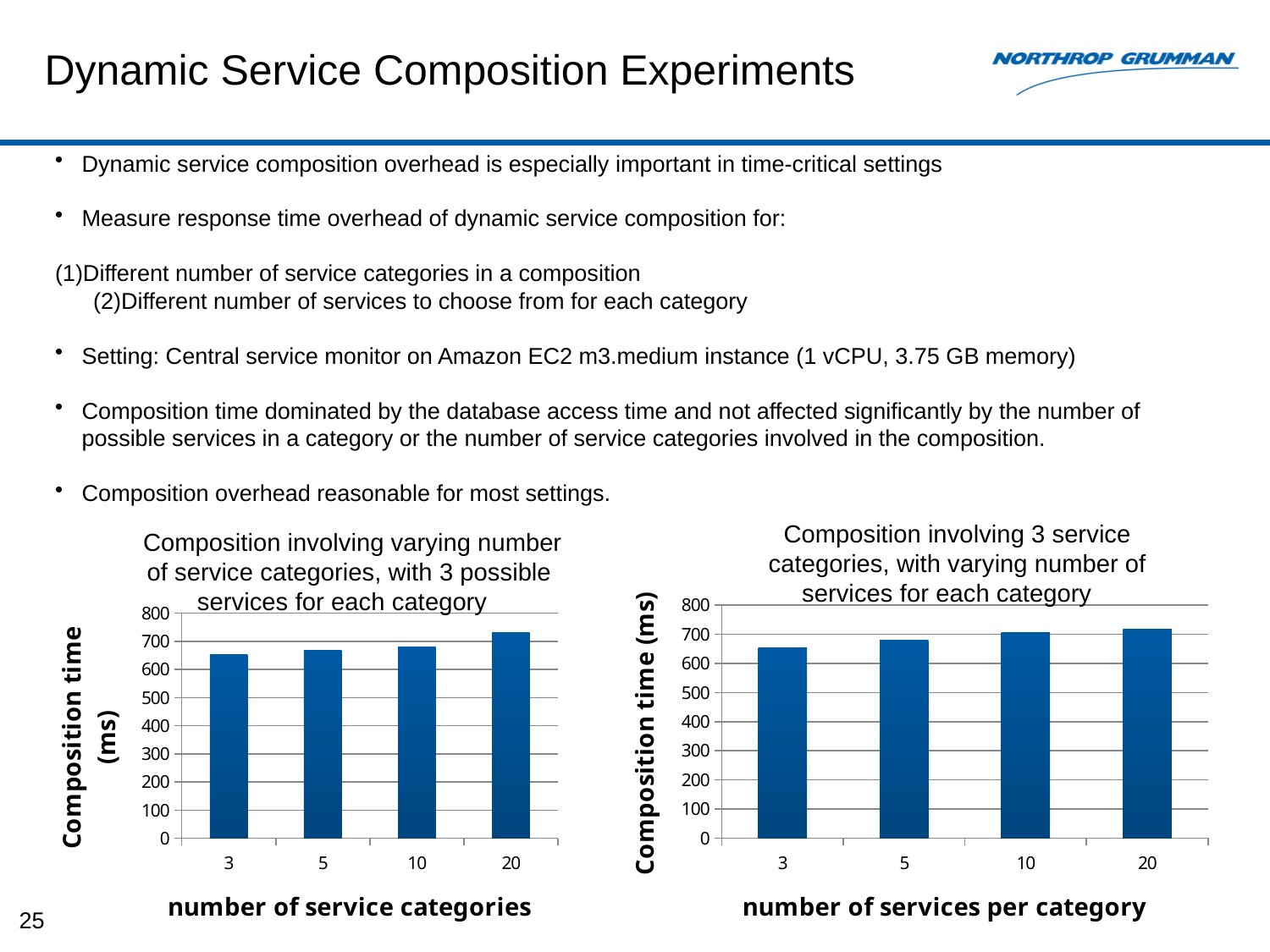
In the left chart (varying number of service categories), do the composition times rise or fall as the number of service categories increases from 3 to 20? rise In the left chart (varying number of service categories), is the composition time for 3 service categories greater or less than 600 ms? greater In the left chart (varying number of service categories), which number of service categories has the highest composition time? 20 In the right chart (varying number of services per category), which has the larger composition time: 3 services per category or 20 services per category? 20 In the left chart (varying number of service categories), how many bars are plotted? 4 In the right chart (varying number of services per category), how many categories are shown on the x axis? 4 What is the x-axis title of the right chart? number of services per category In the right chart (varying number of services per category), do the composition times rise or fall as the number of services per category increases from 3 to 20? rise In the right chart (varying number of services per category), is the composition time for 3 services per category greater or less than 700 ms? less What kind of chart is the left chart, titled "Composition involving varying number of service categories, with 3 possible services for each category"? bar chart In the left chart (varying number of service categories), is the composition time for 20 service categories greater or less than 800 ms? less In the right chart (varying number of services per category), which number of services per category has the lowest composition time? 3